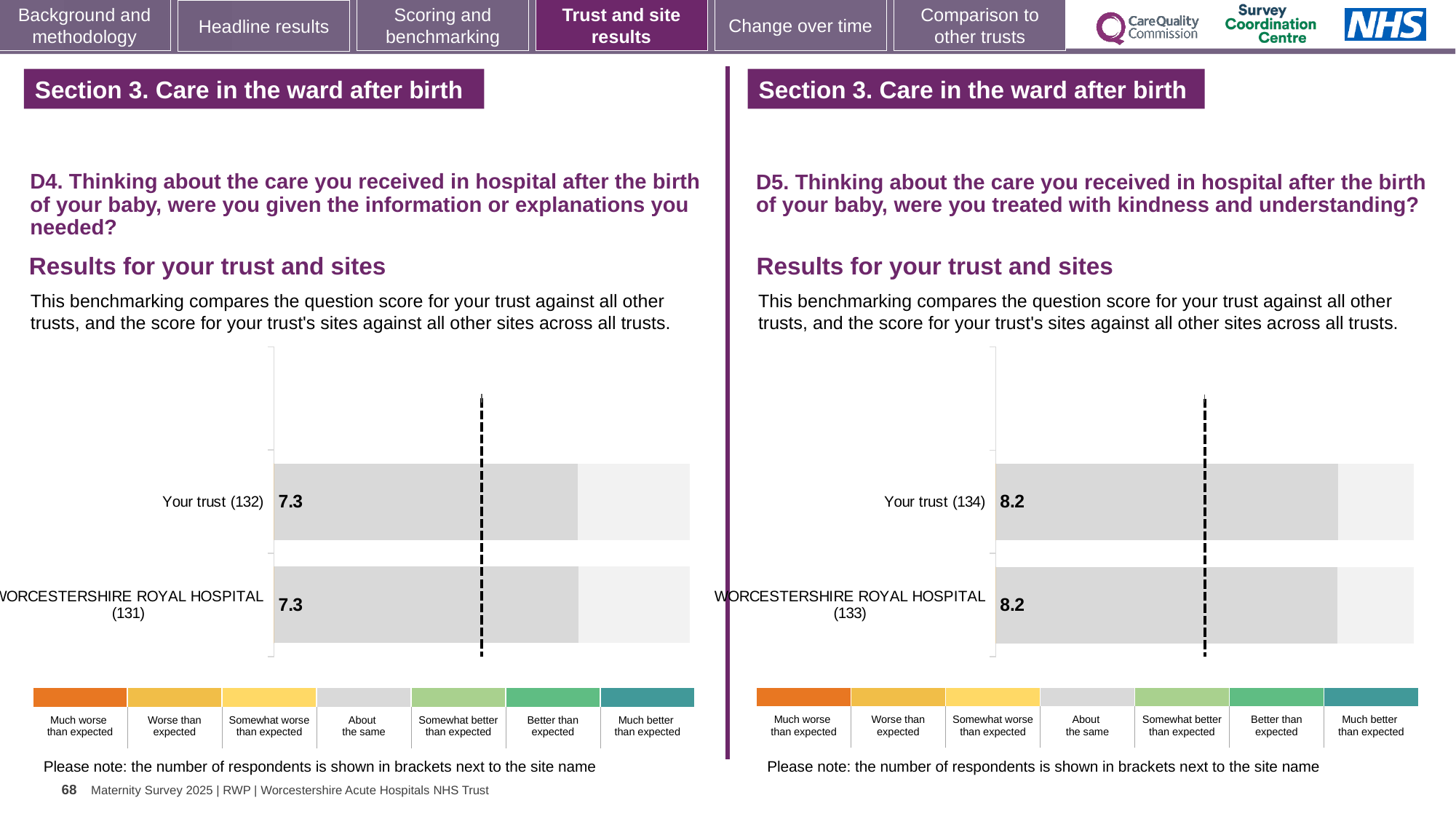
On the left chart (D4), what is the score for Your trust? 7.3 What kind of chart is used on the left (D4) to show the results for your trust and sites? Bar chart On the left chart (D4), how many respondents are shown in brackets for Your trust? 132 On the left chart (D4), what is the difference between the score for Your trust and the score for WORCESTERSHIRE ROYAL HOSPITAL? 0 On the right chart (D5), what is the difference between the score for Your trust and the score for WORCESTERSHIRE ROYAL HOSPITAL? 0 On the left chart (D4), what is the score for WORCESTERSHIRE ROYAL HOSPITAL? 7.3 On the right chart (D5), what is the score for Your trust? 8.2 Is the score for Your trust on the right chart (D5) larger or smaller than the score for Your trust on the left chart (D4)? Larger On the right chart (D5), what is the score for WORCESTERSHIRE ROYAL HOSPITAL? 8.2 How many bars are plotted on the right chart (D5)? 2 How many bars are plotted on the left chart (D4)? 2 On the right chart (D5), how many respondents are shown in brackets for WORCESTERSHIRE ROYAL HOSPITAL? 133